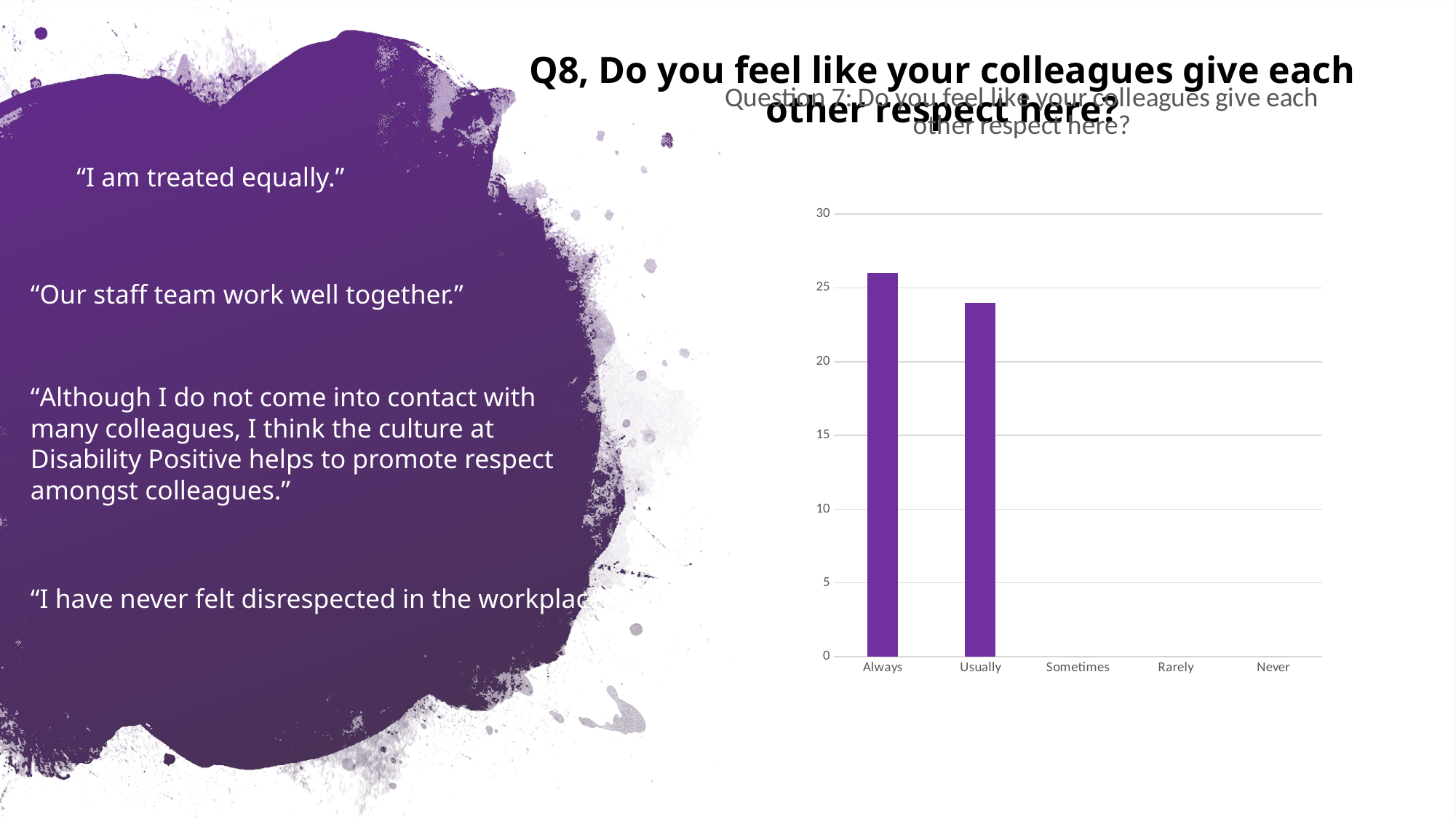
Which is larger, the value for Always or the value for Usually? Always What is the label of the last category on the x axis? Never Is the value for Always greater or less than 30? less Which category has the highest value in the chart? Always Do the values rise or fall moving from Always to Never along the x axis? fall What kind of chart is shown on the slide? bar chart How many categories are shown on the x axis of the chart? 5 What is the highest value shown on the chart's vertical axis? 30 Is the value for Always greater or less than 25? greater Is the value for Usually greater or less than 20? greater